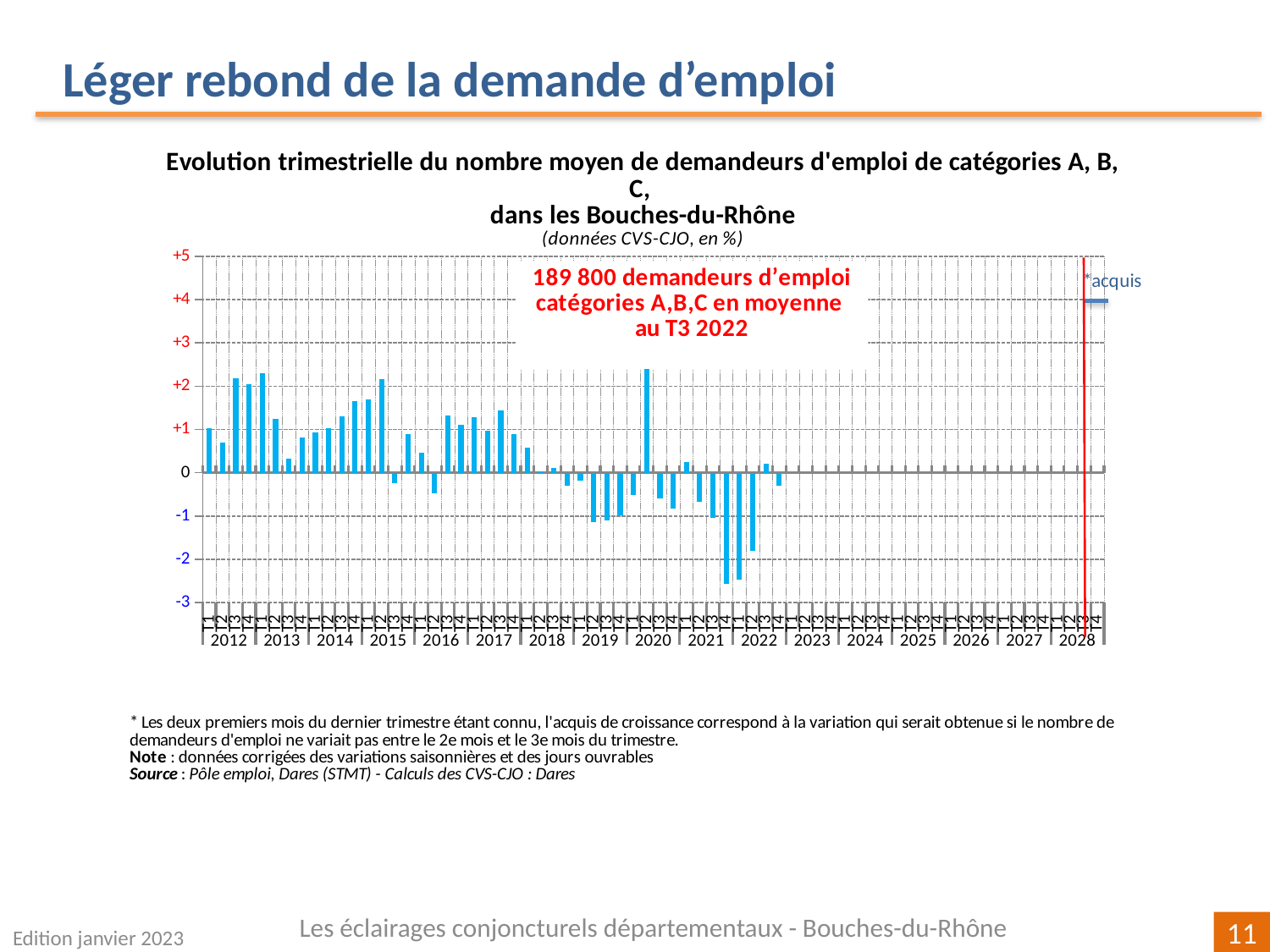
Is the value for T1 2016 greater or less than 0? greater What kind of chart is shown on the slide? bar chart Which is larger, the value for T2 2020 or the value for T1 2019? T2 2020 Is the value for T1 2022 greater or less than -2? less What is the highest value shown on the vertical axis? +5 Is the value for T2 2015 greater or less than +2? greater What is the title of the chart? Evolution trimestrielle du nombre moyen de demandeurs d'emploi de catégories A, B, C, dans les Bouches-du-Rhône Do the values rise or fall from T4 2021 to T3 2022? rise According to the annotation on the chart, how many demandeurs d'emploi catégories A,B,C were there on average in T3 2022? 189 800